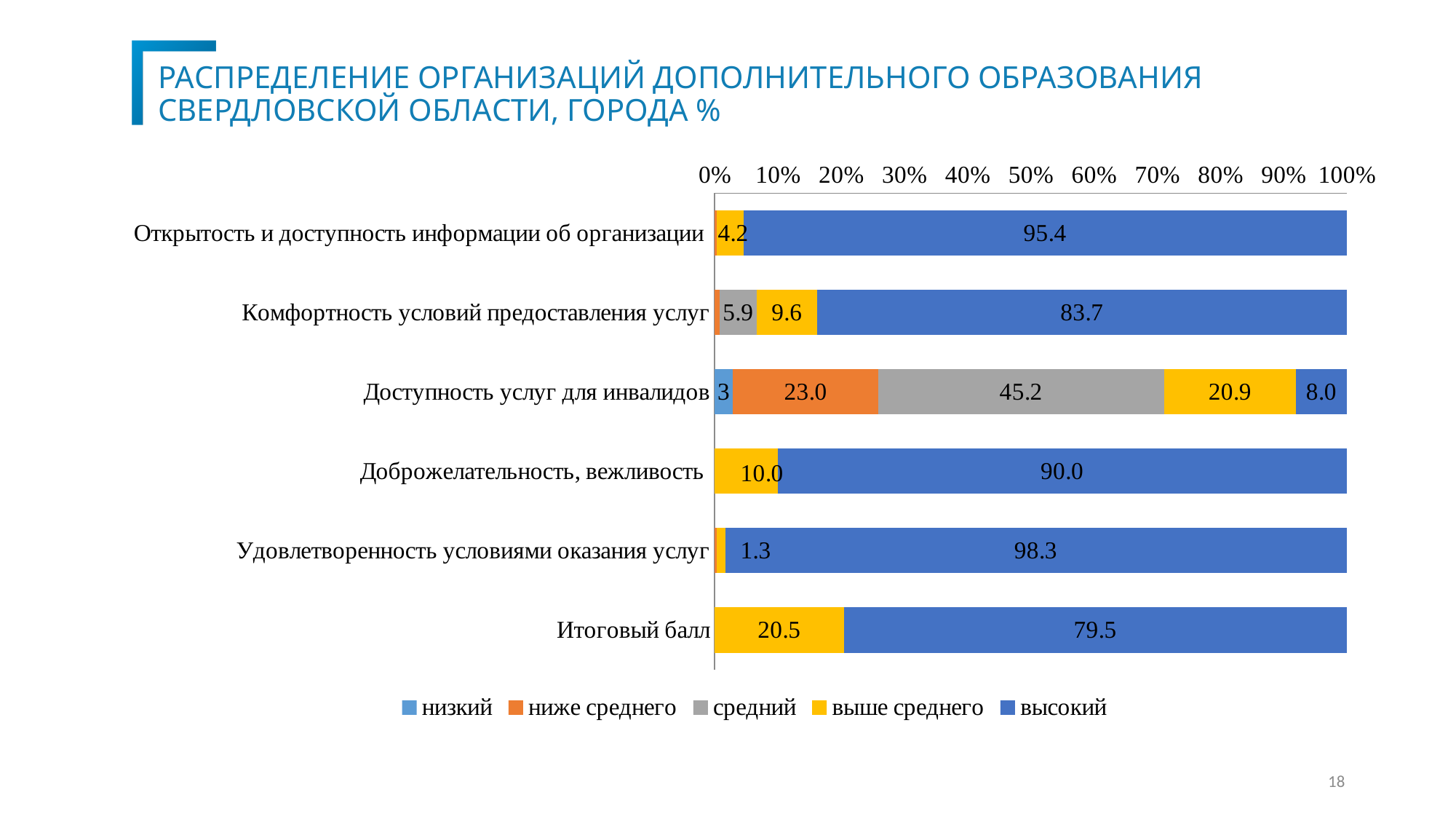
What is the difference between the 'высокий' values for 'Доброжелательность, вежливость' and 'Комфортность условий предоставления услуг'? 6.3 What is the value of the 'средний' segment for 'Доступность услуг для инвалидов'? 45.2 What is the value of the 'высокий' segment for 'Открытость и доступность информации об организации'? 95.4 Which is larger: the 'выше среднего' value for 'Доступность услуг для инвалидов' or for 'Итоговый балл'? Доступность услуг для инвалидов How many categories are plotted on the chart? 6 Which legend entry is shown in orange? ниже среднего What is the value of the 'выше среднего' segment for 'Итоговый балл'? 20.5 How many series does the legend list? 5 What is the value of the 'ниже среднего' segment for 'Доступность услуг для инвалидов'? 23.0 Which category has the lowest 'высокий' value? Доступность услуг для инвалидов What kind of chart is shown on the slide? Stacked bar chart Which category has the highest 'высокий' value? Удовлетворенность условиями оказания услуг